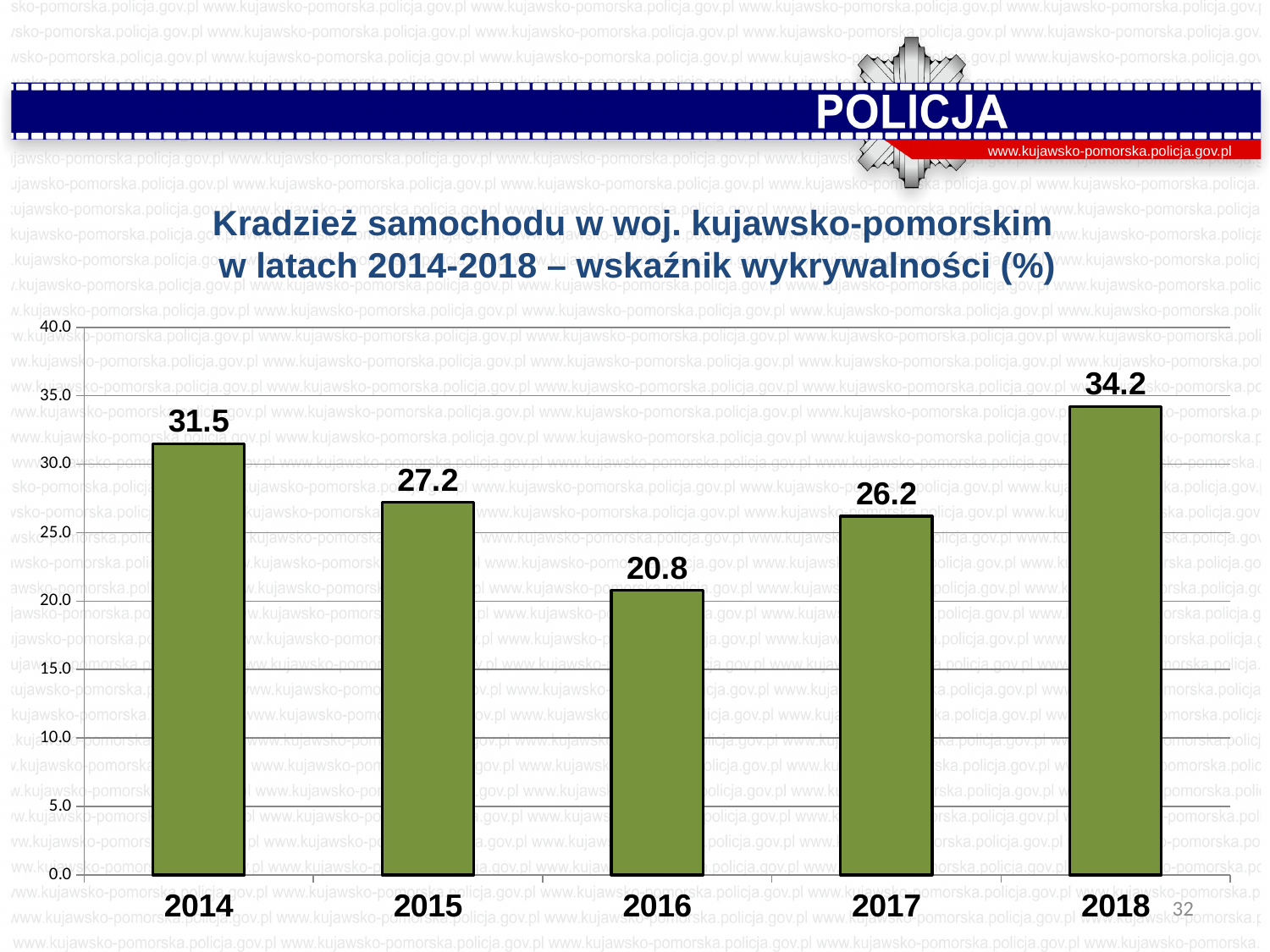
Which year has a higher detection rate, 2015 or 2017? 2015 Does the detection rate rise or fall from 2016 to 2018? rise How many years are shown on the chart? 5 What kind of chart is shown on the slide? bar chart Is the value for 2017 greater or less than 25.0? greater What is the detection rate for 2016? 20.8 What is the detection rate for 2014? 31.5 Which year has the lowest detection rate? 2016 Which year has the highest detection rate? 2018 What is the difference between the detection rate in 2014 and in 2015? 4.3 What is the detection rate for 2018? 34.2 What is the difference between the detection rate in 2018 and in 2016? 13.4